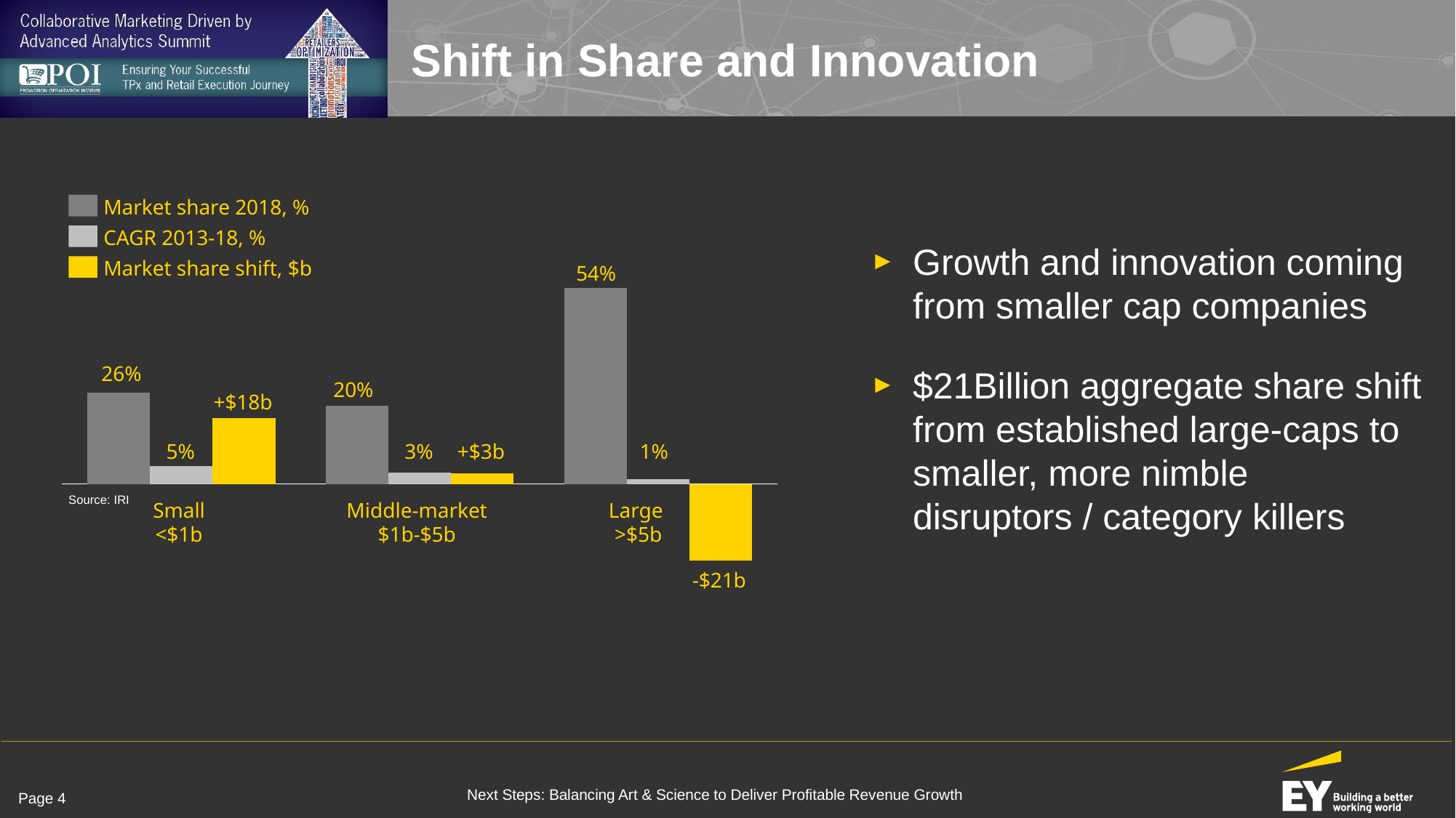
What kind of chart is shown on the slide? Bar chart Which category has the highest Market share 2018, %? Large >$5b What is the Market share shift, $b value for Large >$5b? -$21b How many categories are shown on the x axis? 3 What is the Market share 2018, % value for Large >$5b? 54% What colour represents the Market share shift, $b series? Yellow What is the difference in Market share 2018, % between Large >$5b and Small <$1b? 28% Which is larger, the Market share 2018, % for Small <$1b or for Middle-market $1b-$5b? Small <$1b How many series does the legend list? 3 What is the CAGR 2013-18, % value for Small <$1b? 5% Which category has the lowest CAGR 2013-18, %? Large >$5b What is the Market share shift, $b value for Middle-market $1b-$5b? +$3b